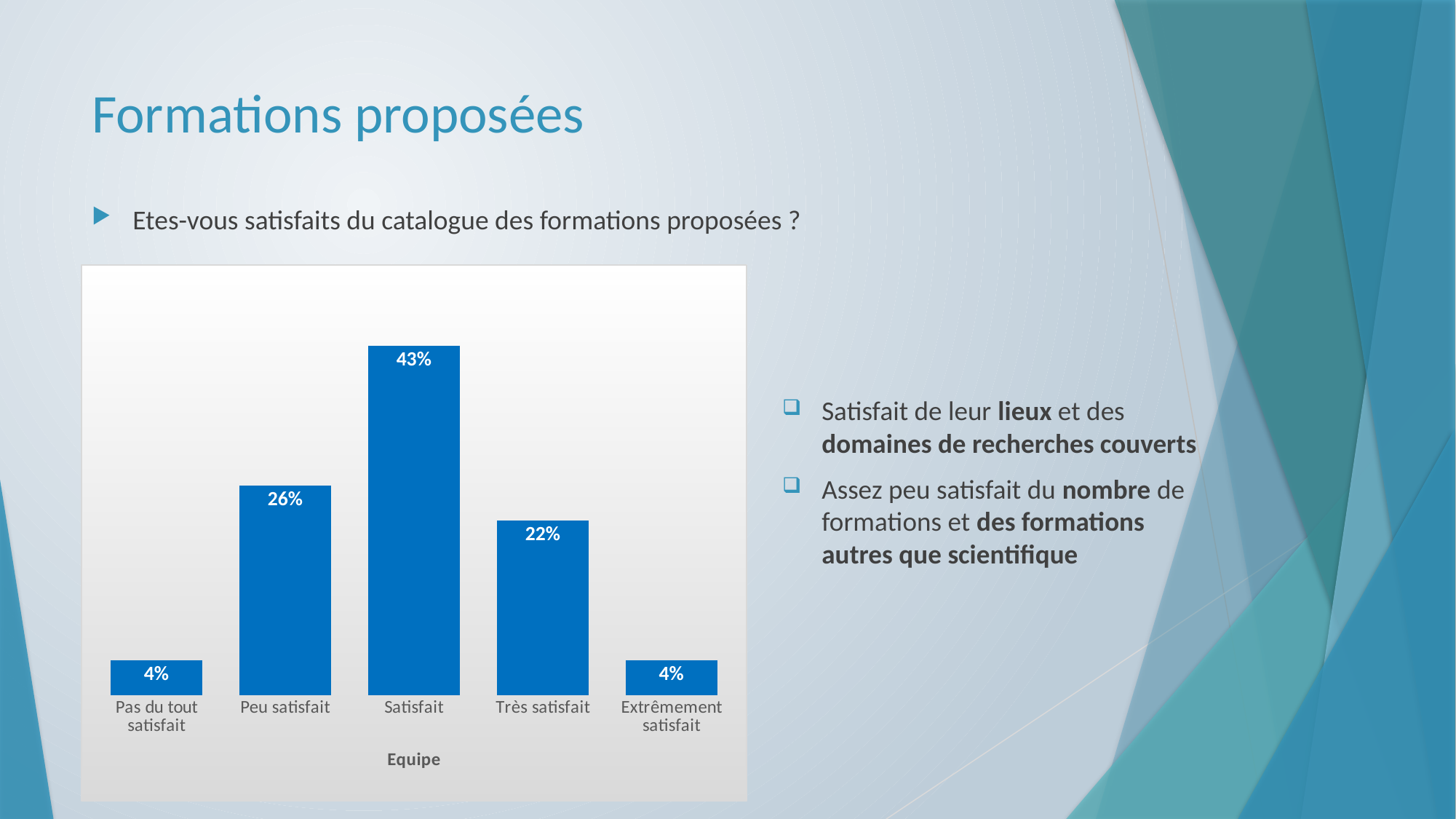
Which is larger, the value for Peu satisfait or the value for Très satisfait? Peu satisfait What is the value for Satisfait? 43% What is the value for Extrêmement satisfait? 4% What is the value for Très satisfait? 22% What is the value for Peu satisfait? 26% Which category has the highest value? Satisfait What is the difference between the values for Satisfait and Peu satisfait? 17% What is the value for Pas du tout satisfait? 4% What type of chart is shown on the slide? bar chart What is the difference between the values for Peu satisfait and Très satisfait? 4% What is the title shown below the x axis of the chart? Equipe How many categories are shown on the x axis? 5